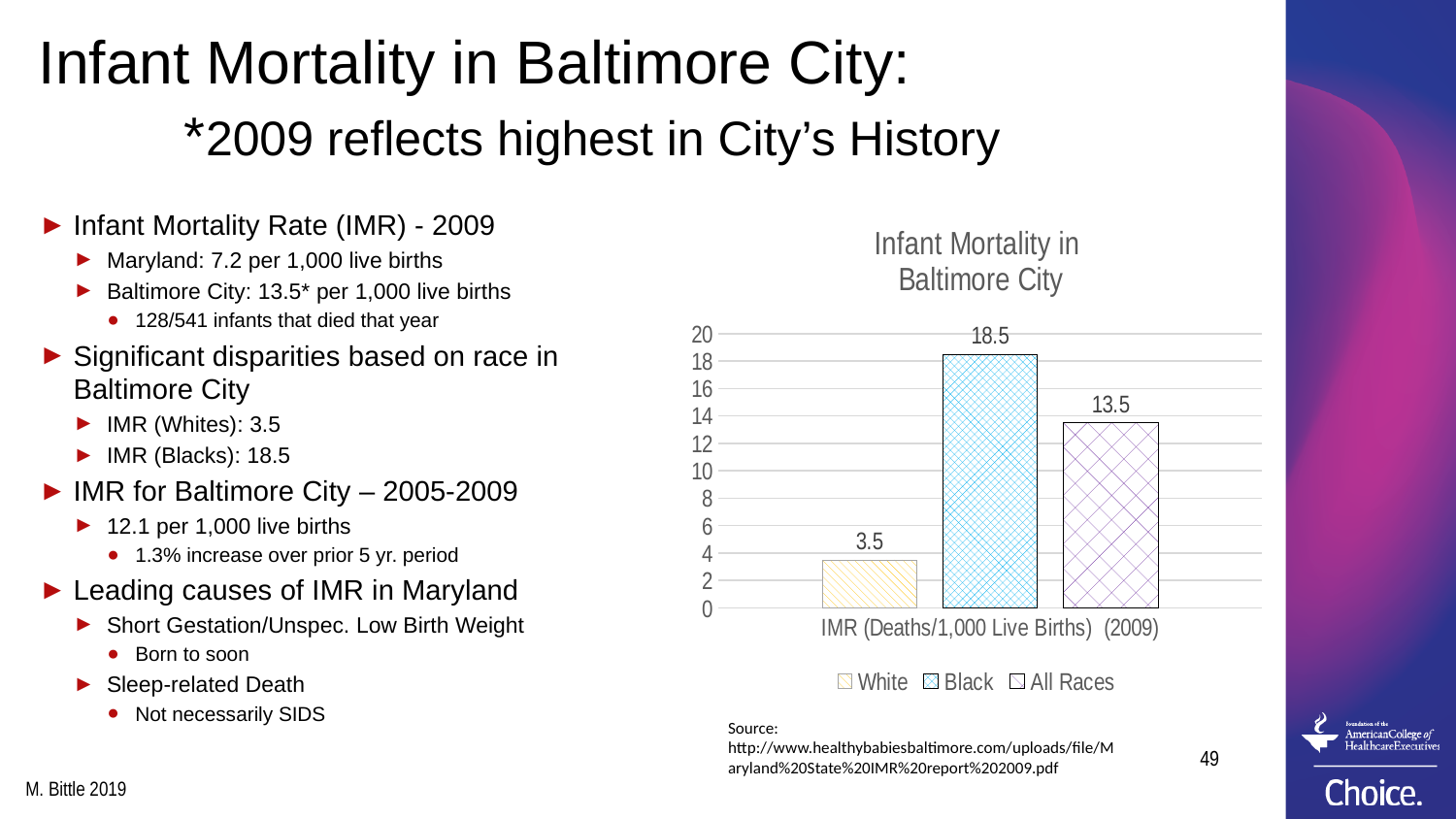
Is the IMR value for All Races greater or less than 10? greater What is the IMR value for Black in the chart? 18.5 Which series has the highest IMR in the chart? Black Which is larger, the IMR for All Races or the IMR for White? All Races What kind of chart is shown on the slide? Bar chart What is the IMR value for White in the chart? 3.5 What is the IMR value for All Races in the chart? 13.5 What is the difference between the IMR for Black and the IMR for All Races? 5 Which series has the lowest IMR in the chart? White How many series does the chart legend list? 3 What is the difference between the IMR for Black and the IMR for White? 15 What is the title of the chart? Infant Mortality in Baltimore City